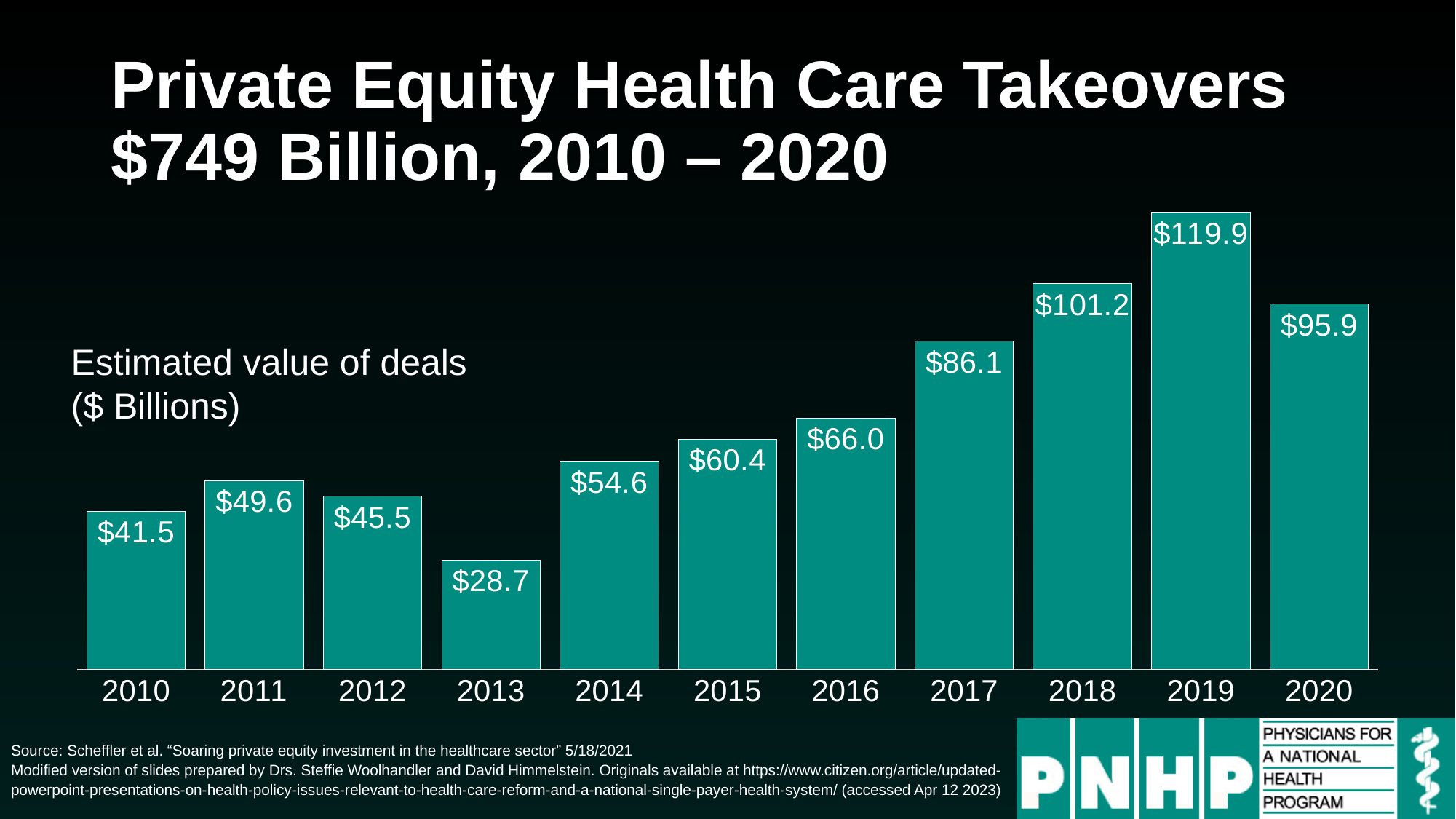
What is the estimated value of deals for 2016? $66.0 What is the difference between the values for 2019 and 2020? $24.0 What is the estimated value of deals for 2013? $28.7 Which year has the highest estimated value of deals? 2019 Which year has a larger value, 2020 or 2018? 2018 How many years are shown on the x axis of the chart? 11 What is the estimated value of deals for 2019? $119.9 What unit are the values in the chart expressed in? $ Billions Which year has the lowest estimated value of deals? 2013 What kind of chart is shown on the slide? Bar chart What is the difference between the values for 2018 and 2017? $15.1 Which year has a larger value, 2011 or 2012? 2011